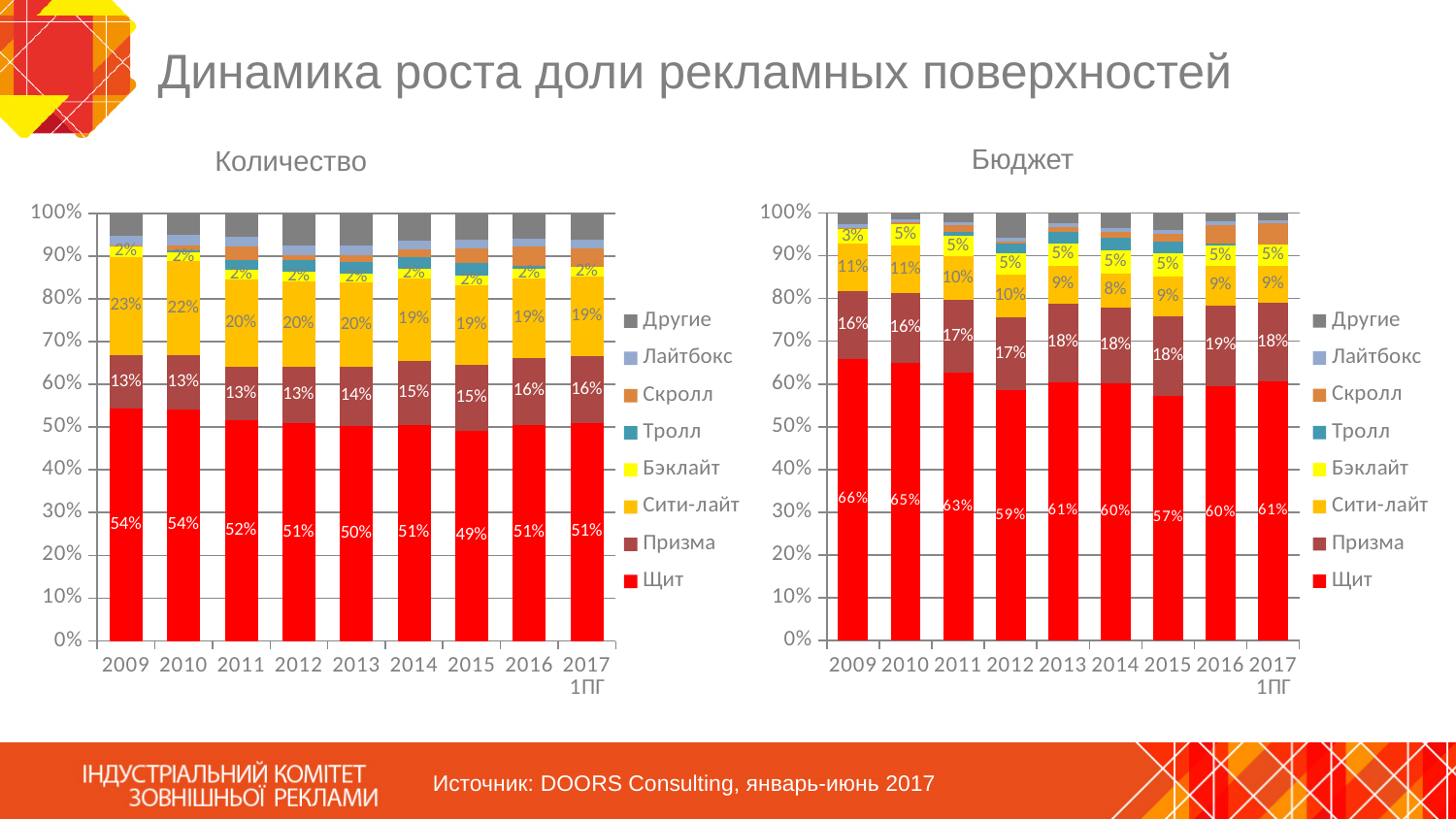
In the Бюджет chart, which year has the highest value for Щит? 2009 In the Количество chart, which is larger: the Сити-лайт value in 2009 or in 2017 1ПГ? 2009 In the Бюджет chart, what is the difference between the Щит value in 2009 and in 2015? 9% In the Количество chart, what is the value for Сити-лайт in 2009? 23% How many years (categories) are shown on the x axis of the Количество chart? 9 In the Бюджет chart, does the Сити-лайт value rise or fall from 2009 to 2017 1ПГ? Fall In the Количество chart, what is the value for Щит in 2009? 54% In the Бюджет chart, what is the value for Щит in 2015? 57% In the Количество chart, which year has the lowest value for Щит? 2015 In the Бюджет chart, what is the value for Призма in 2016? 19% What kind of chart is the Бюджет chart? Stacked bar chart How many series does the legend of the Бюджет chart list? 8